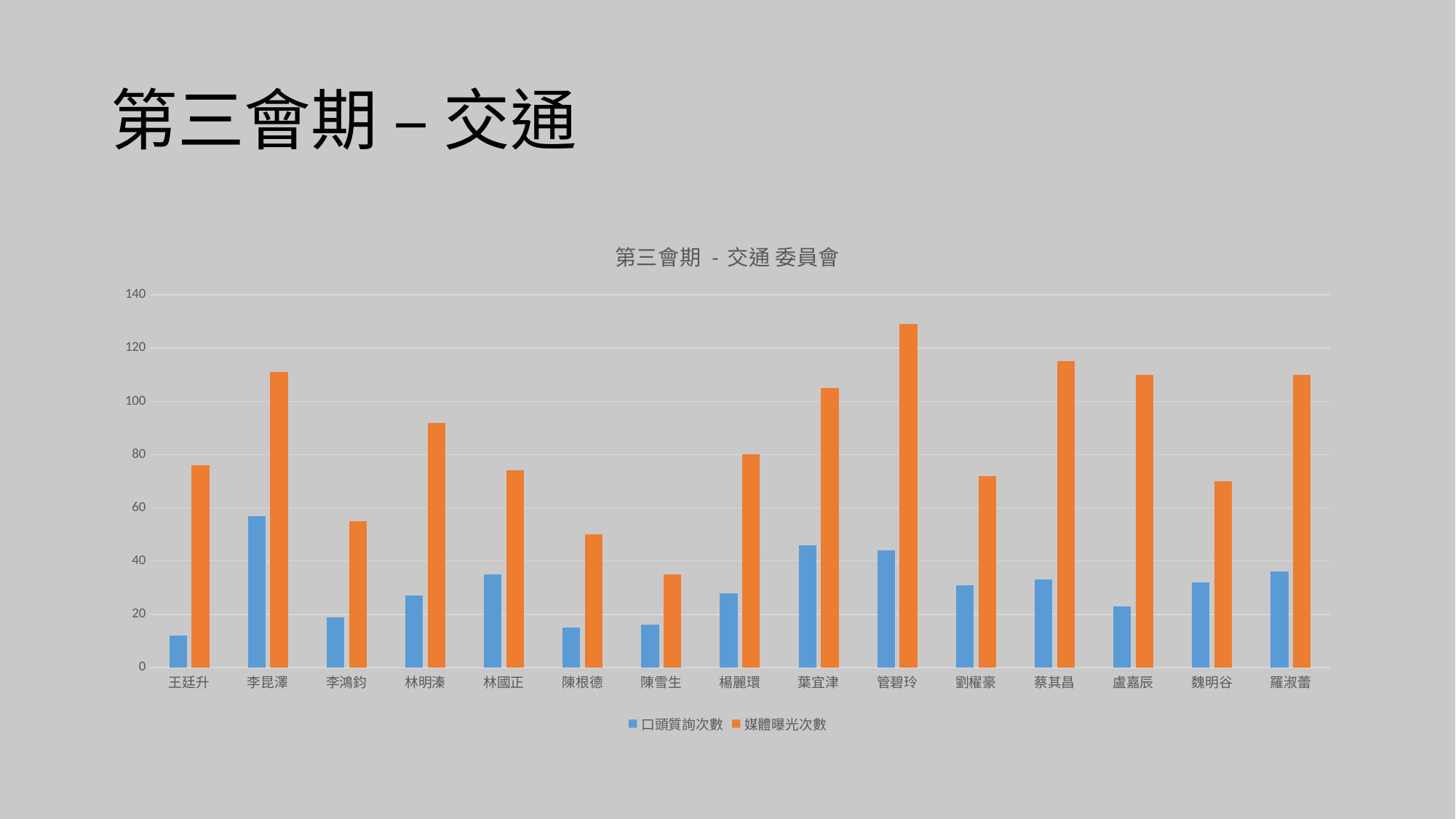
How many legislators (categories) are shown on the x axis? 15 How many series does the legend list? 2 Which legislator has the lowest 媒體曝光次數? 陳雪生 What kind of chart is shown on the slide? bar chart Which legislator has the highest 口頭質詢次數? 李昆澤 Which series is shown in orange? 媒體曝光次數 What is the title of the chart? 第三會期 - 交通 委員會 Is the 媒體曝光次數 value for 陳雪生 greater or less than 40? less Is the 口頭質詢次數 value for 李昆澤 greater or less than 60? less Which legislator has the highest 媒體曝光次數? 管碧玲 Which is larger, the 媒體曝光次數 for 蔡其昌 or for 劉櫂豪? 蔡其昌 Is the 媒體曝光次數 value for 管碧玲 greater or less than 120? greater